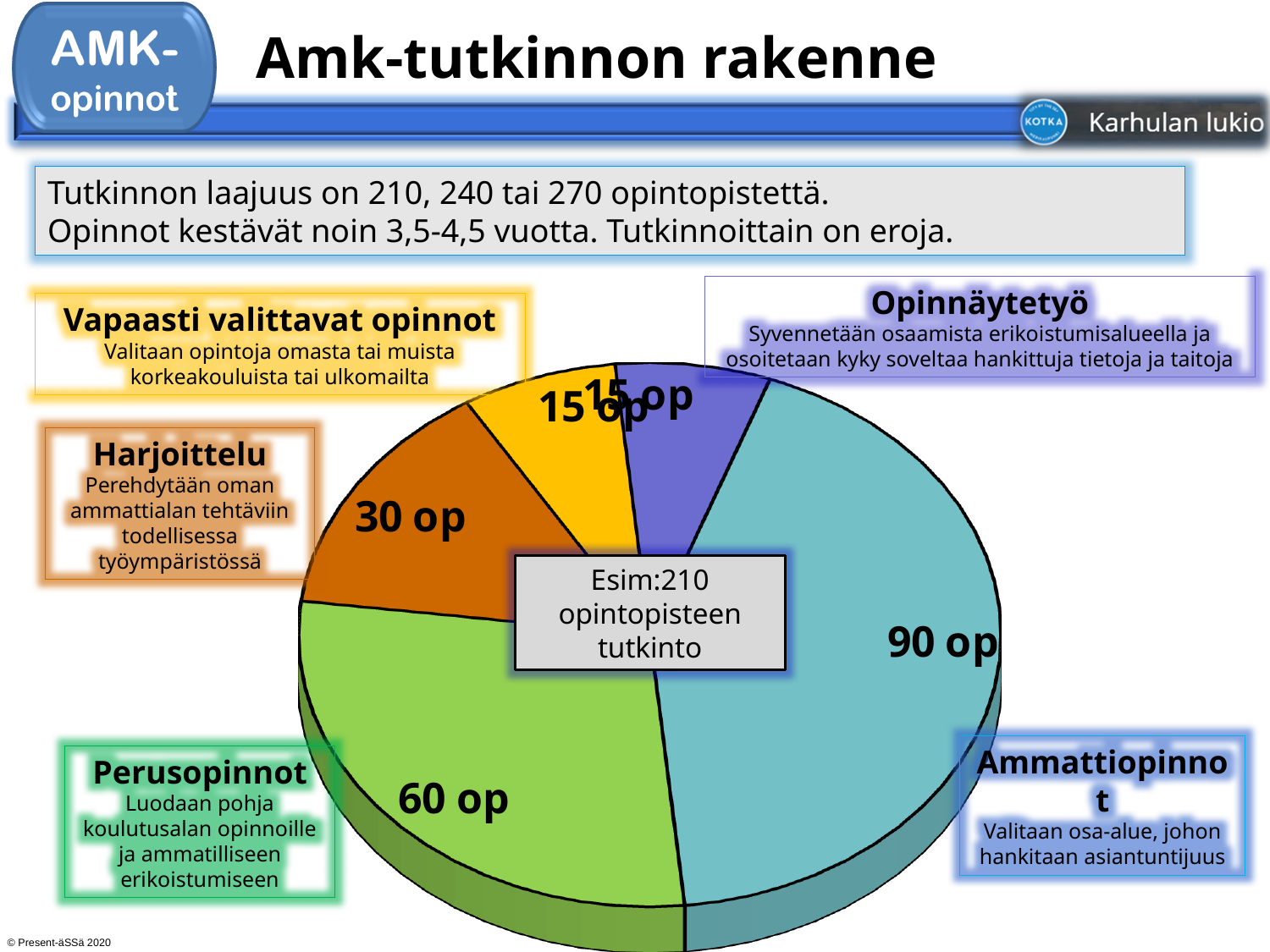
What value is shown for the Harjoittelu slice? 30 op What is the difference between the Ammattiopinnot slice and the Perusopinnot slice? 30 op What colour is the 90 op slice of the pie chart? light blue (teal) What text is shown in the box at the centre of the pie chart? Esim:210 opintopisteen tutkinto What is the total of all the slice values in the pie chart? 210 op What value is shown for the Opinnäytetyö slice? 15 op How many slices does the pie chart have? 5 Which is larger, the Perusopinnot slice or the Harjoittelu slice? Perusopinnot What kind of chart is shown on the slide? pie chart How many opintopisteet (op) does the Ammattiopinnot slice represent? 90 op What value is shown for the Perusopinnot slice? 60 op Which slice of the pie chart is the largest? Ammattiopinnot